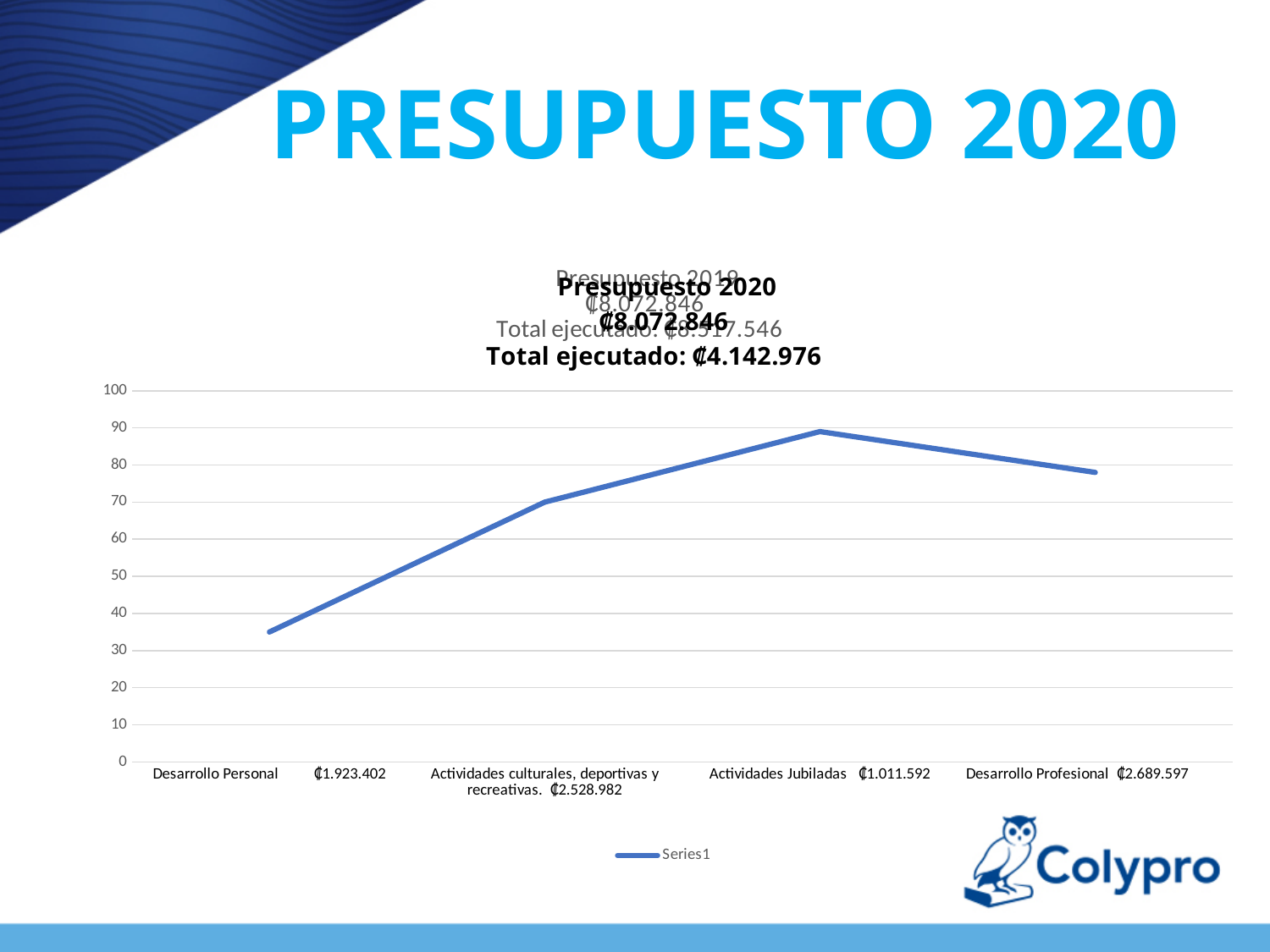
What is the name of the series shown in the chart legend? Series1 What kind of chart is shown on the slide? line chart Is the value for Desarrollo Personal greater or less than 40? less Which has the larger value, Desarrollo Personal or Desarrollo Profesional? Desarrollo Profesional Which category has the lowest value on the line? Desarrollo Personal Which category has the highest value on the line? Actividades Jubiladas Does the line rise or fall between Actividades Jubiladas and Desarrollo Profesional? fall Is the value for Actividades Jubiladas greater or less than 80? greater How many series does the chart legend list? 1 Is the value for Desarrollo Personal greater or less than 30? greater How many categories are plotted along the x axis of the chart? 4